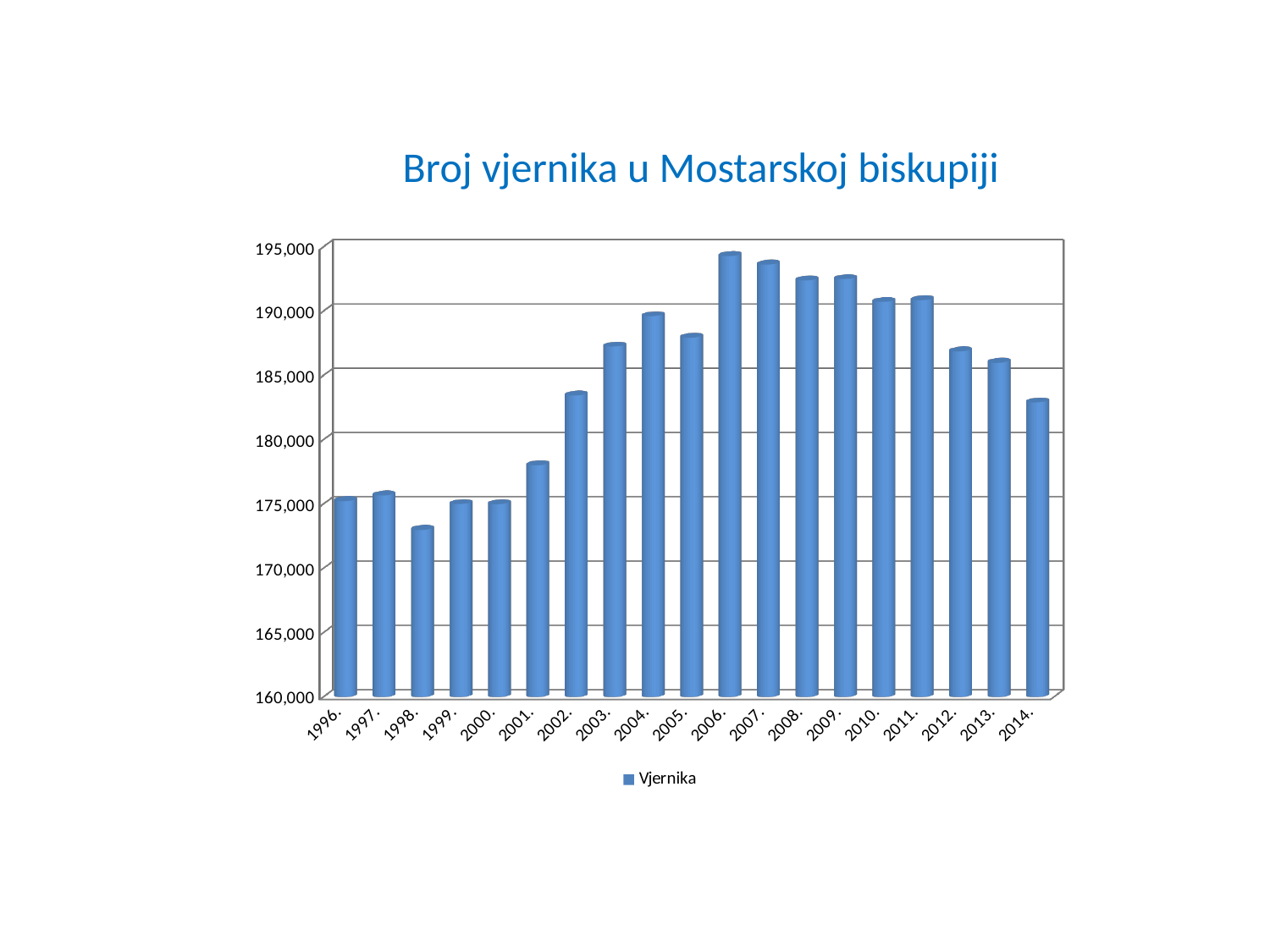
What series name does the legend list? Vjernika Is the value for 2001. greater or less than 180,000? less What is the title of the chart? Broj vjernika u Mostarskoj biskupiji Which year has the highest value? 2006. Which year has the lowest value? 1998. Is the value for 2014. greater or less than 185,000? less Which is larger, the value for 2006. or the value for 2014.? 2006. How many years are shown on the x axis? 19 Is the value for 2008. greater or less than 190,000? greater Do the values rise or fall from 2006. to 2014.? fall What kind of chart is shown on the slide? bar chart How many series does the legend list? 1